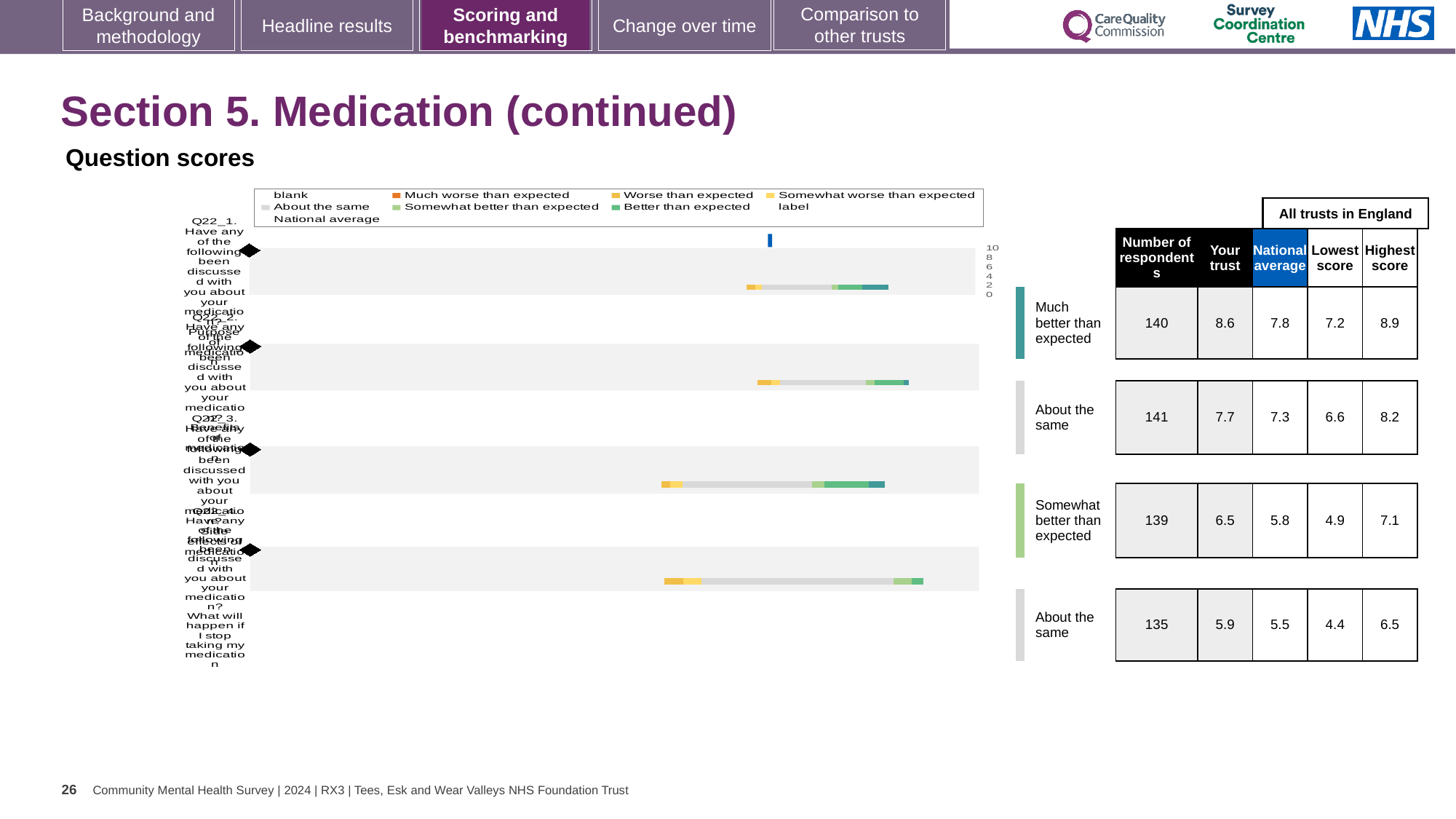
What kind of chart is shown under 'Question scores'? bar chart For the second row, which is larger: the 'Your trust' score or the national average? Your trust (7.7) What is the national average for the second row of the table? 7.3 Which row of the table has the highest 'Your trust' score? the first row (8.6) In the table beside the chart, what is the number of respondents for the first row (Much better than expected)? 140 How many question rows (bars) are plotted in the chart? 4 What is the 'Your trust' score for the first row of the table? 8.6 Which row of the table has the lowest 'Your trust' score? the fourth row (5.9) What is the lowest score across all trusts in England for the fourth row of the table? 4.4 What is the highest score across all trusts in England for the third row of the table? 7.1 For the first row, what is the difference between the 'Your trust' score and the national average? 0.8 What benchmark label is given to the third row of the table? Somewhat better than expected